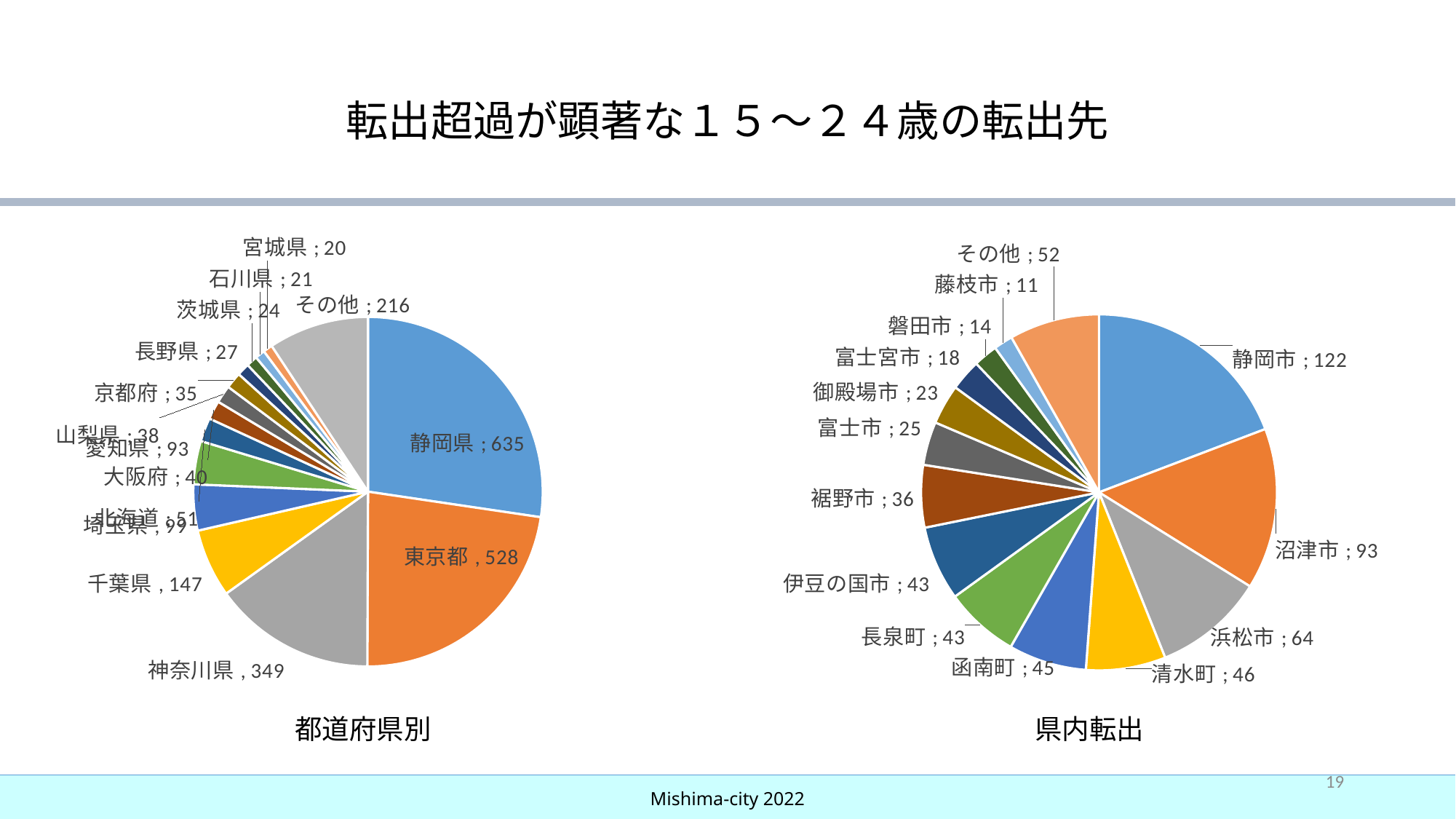
What type of chart is the 県内転出 chart? Pie chart In the 都道府県別 pie chart, what is the value for その他? 216 What is the title of the slide? 転出超過が顕著な１５～２４歳の転出先 In the 都道府県別 pie chart, what is the value for 神奈川県? 349 In the 県内転出 pie chart, how many categories are shown? 14 In the 県内転出 pie chart, which category has the smallest value? 藤枝市 In the 都道府県別 pie chart, which is larger, 東京都 or 神奈川県? 東京都 In the 県内転出 pie chart, what is the value for 沼津市? 93 In the 都道府県別 pie chart, what is the difference between 東京都 and 千葉県? 381 In the 県内転出 pie chart, what is the difference between 静岡市 and 浜松市? 58 In the 都道府県別 pie chart, which category has the largest value? 静岡県 In the 都道府県別 pie chart, what is the value for 静岡県? 635